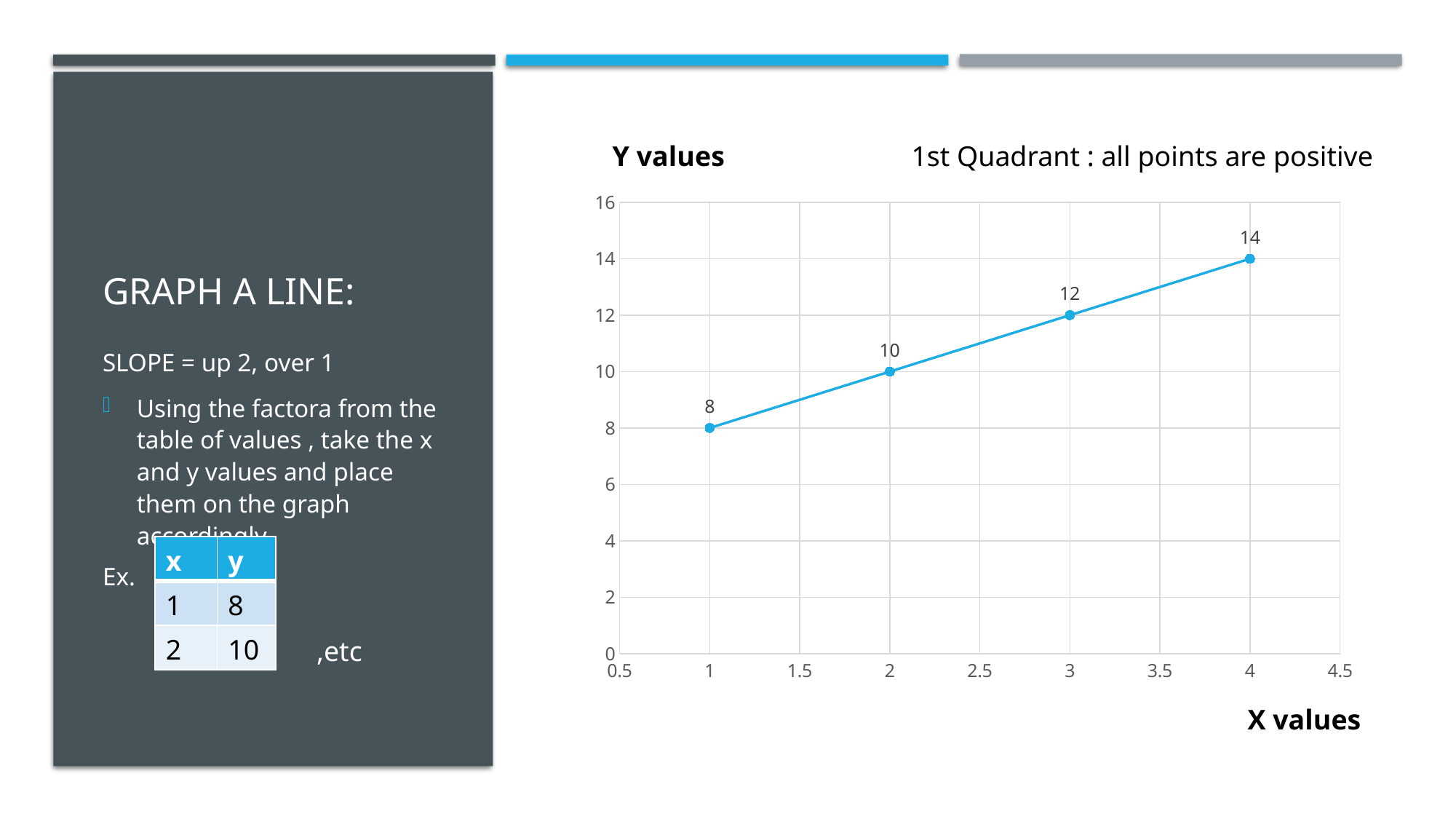
Is the y value at x = 2 greater or less than 12? less What is the difference between the y value at x = 4 and the y value at x = 1? 6 What is the y value at x = 1? 8 At which x value is the y value lowest? 1 What kind of chart is shown on the slide? line chart At which x value is the y value highest? 4 What is the y value at x = 4? 14 Which is larger, the y value at x = 2 or the y value at x = 3? x = 3 What is the y value at x = 3? 12 What is the label of the horizontal axis? X values How many data points are plotted on the chart? 4 Do the y values rise or fall as x increases? rise